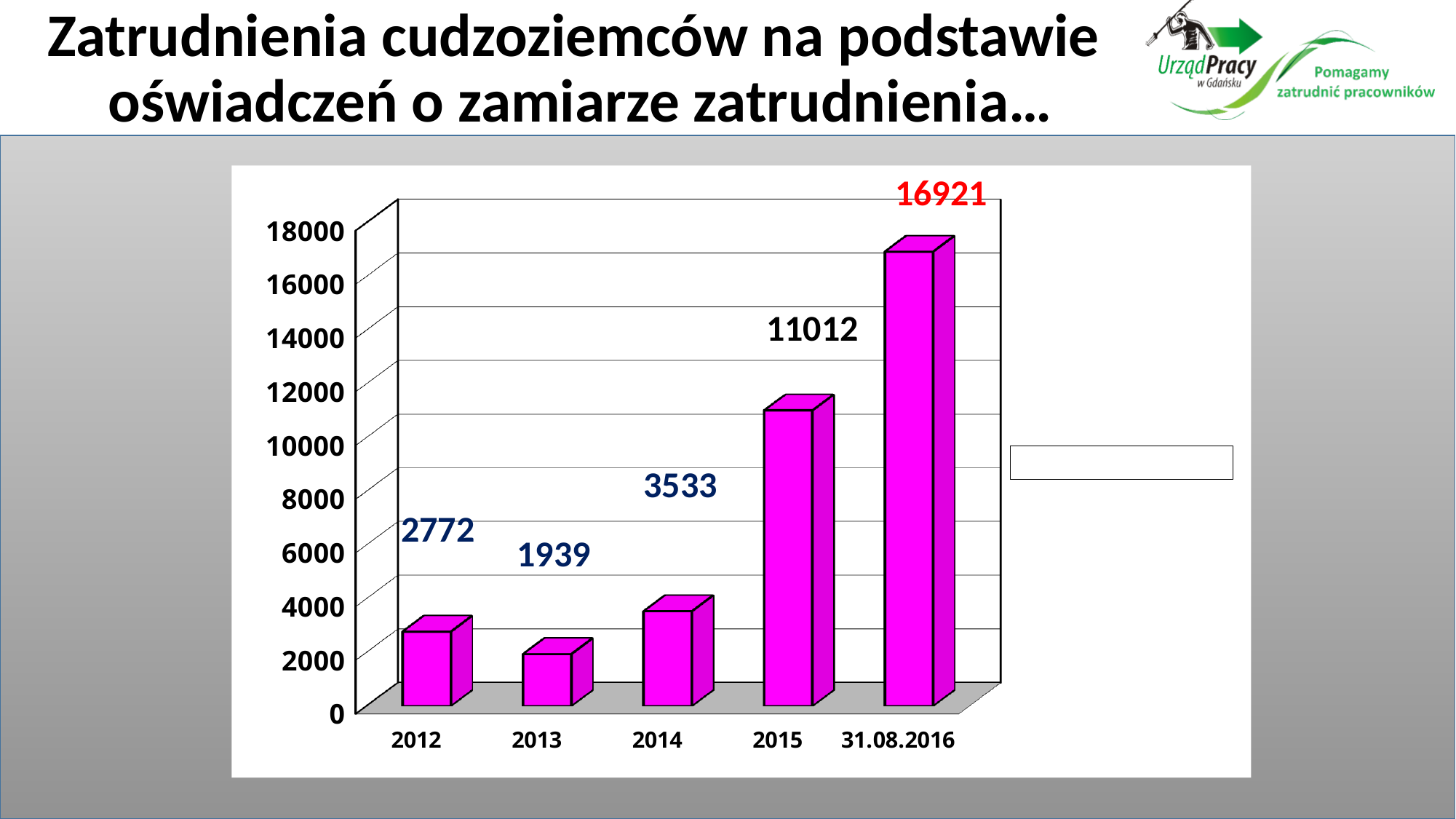
What is the difference between the values for 31.08.2016 and 2015? 5909 Which category has the lowest value? 2013 Is the value for 2015 greater or less than 10000? greater What is the value for 2015? 11012 Which is larger, the value for 2012 or the value for 2014? 2014 How many categories are shown on the x axis? 5 What is the value for 2012? 2772 What is the value for 2013? 1939 What is the value for 2014? 3533 Which category has the highest value? 31.08.2016 What kind of chart is shown on the slide? bar chart What is the value for 31.08.2016? 16921